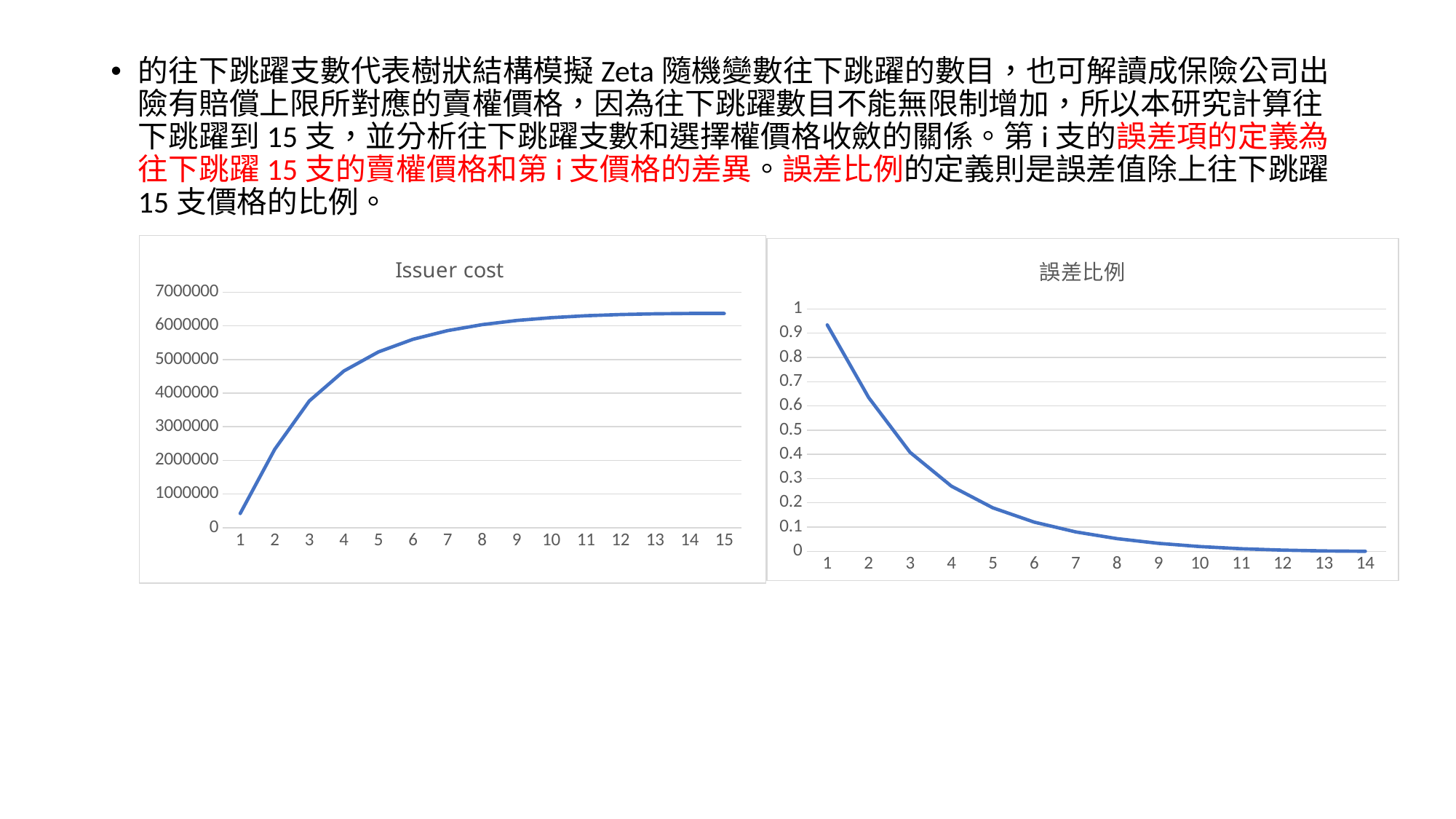
In the "誤差比例" chart, is the value at x = 1 greater or less than 0.9? greater What kind of chart is the "Issuer cost" chart on the left? line chart In the "誤差比例" chart, how many points are plotted along the x axis? 14 In the "Issuer cost" chart, is the value at x = 1 greater or less than 1000000? less In the "誤差比例" chart, is the value at x = 3 greater or less than 0.5? less In the "Issuer cost" chart, which x value has the lowest issuer cost? 1 In the "Issuer cost" chart, do the values rise or fall as x increases from 1 to 15? rise In the "誤差比例" chart, do the values rise or fall as x increases from 1 to 14? fall In the "Issuer cost" chart, how many points are plotted along the x axis? 15 In the "誤差比例" chart, which x value has the highest value? 1 What kind of chart is the "誤差比例" chart on the right? line chart